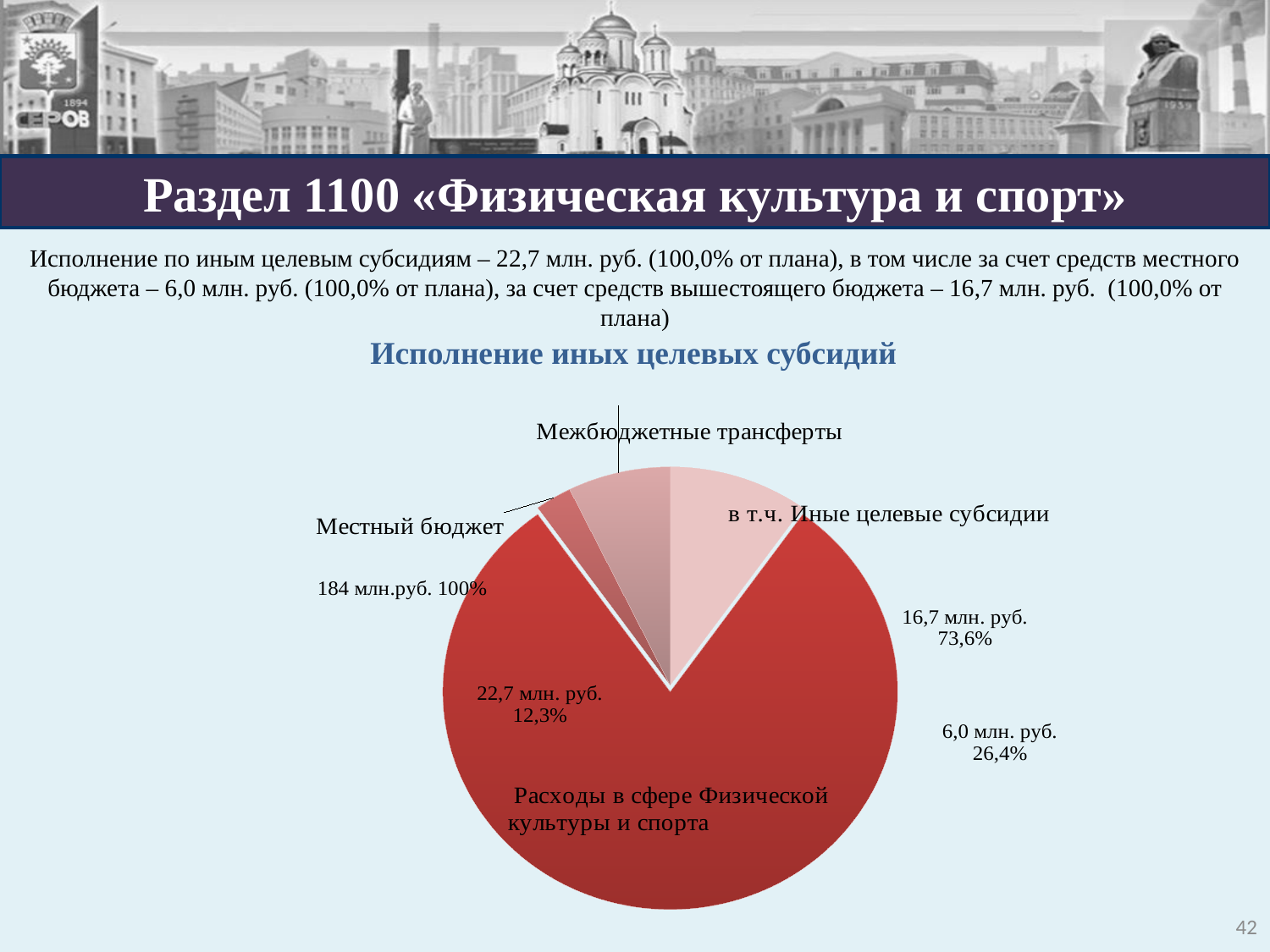
How many slices does the pie chart have? 4 What percentage is printed next to the value 22,7 млн. руб. on the chart? 12,3% What is the title of the chart? Исполнение иных целевых субсидий What is the sum of the values 16,7 млн. руб. and 6,0 млн. руб. shown on the chart? 22,7 млн. руб. Which is larger on the chart: the share labelled 73,6% or the share labelled 26,4%? 73,6% Which slice of the pie chart is the smallest? Местный бюджет What percentage is printed next to the value 6,0 млн. руб. on the chart? 26,4% What is the difference between the values 16,7 млн. руб. and 6,0 млн. руб. shown on the chart? 10,7 млн. руб. Which slice of the pie chart is the largest? Расходы в сфере Физической культуры и спорта What percentage is printed next to the value 16,7 млн. руб. on the chart? 73,6% What kind of chart is shown on the slide? pie chart What value in млн. руб. is printed together with 100% on the chart? 184 млн.руб.